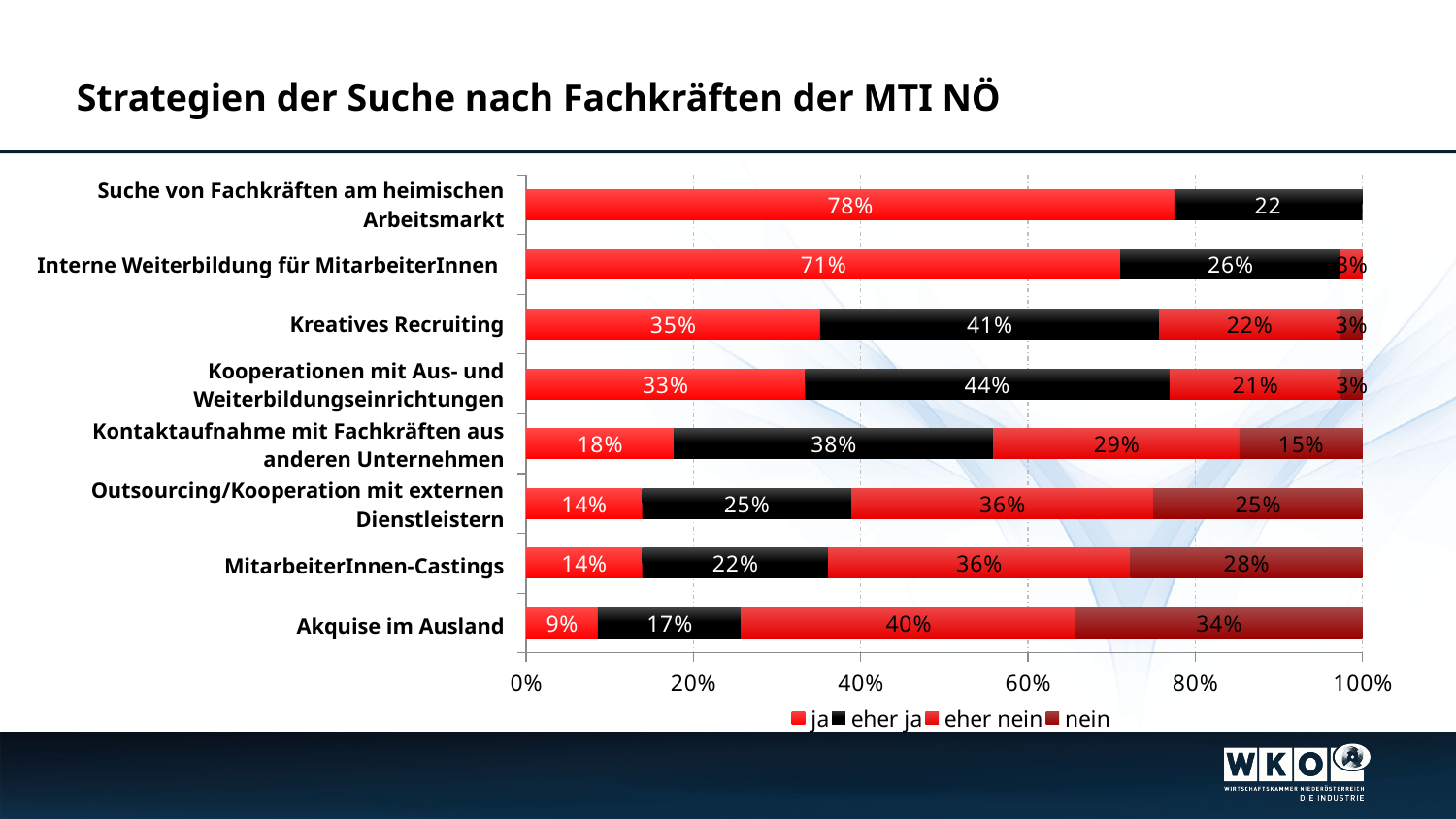
What is the 'eher ja' value for 'Kooperationen mit Aus- und Weiterbildungseinrichtungen'? 44% What is the 'ja' value for 'Suche von Fachkräften am heimischen Arbeitsmarkt'? 78% Which category has the highest 'ja' value? Suche von Fachkräften am heimischen Arbeitsmarkt What kind of chart is shown on the slide? Stacked bar chart Which category has the lowest 'ja' value? Akquise im Ausland What is the title of the chart? Strategien der Suche nach Fachkräften der MTI NÖ How many categories (strategies) are shown on the chart? 8 Which is larger: the 'nein' value for 'MitarbeiterInnen-Castings' or the 'nein' value for 'Kontaktaufnahme mit Fachkräften aus anderen Unternehmen'? MitarbeiterInnen-Castings What is the difference between the 'ja' values for 'Kreatives Recruiting' and 'Akquise im Ausland'? 26% What is the 'eher nein' value for 'Outsourcing/Kooperation mit externen Dienstleistern'? 36% What is the 'nein' value for 'Akquise im Ausland'? 34% How many series does the legend list? 4